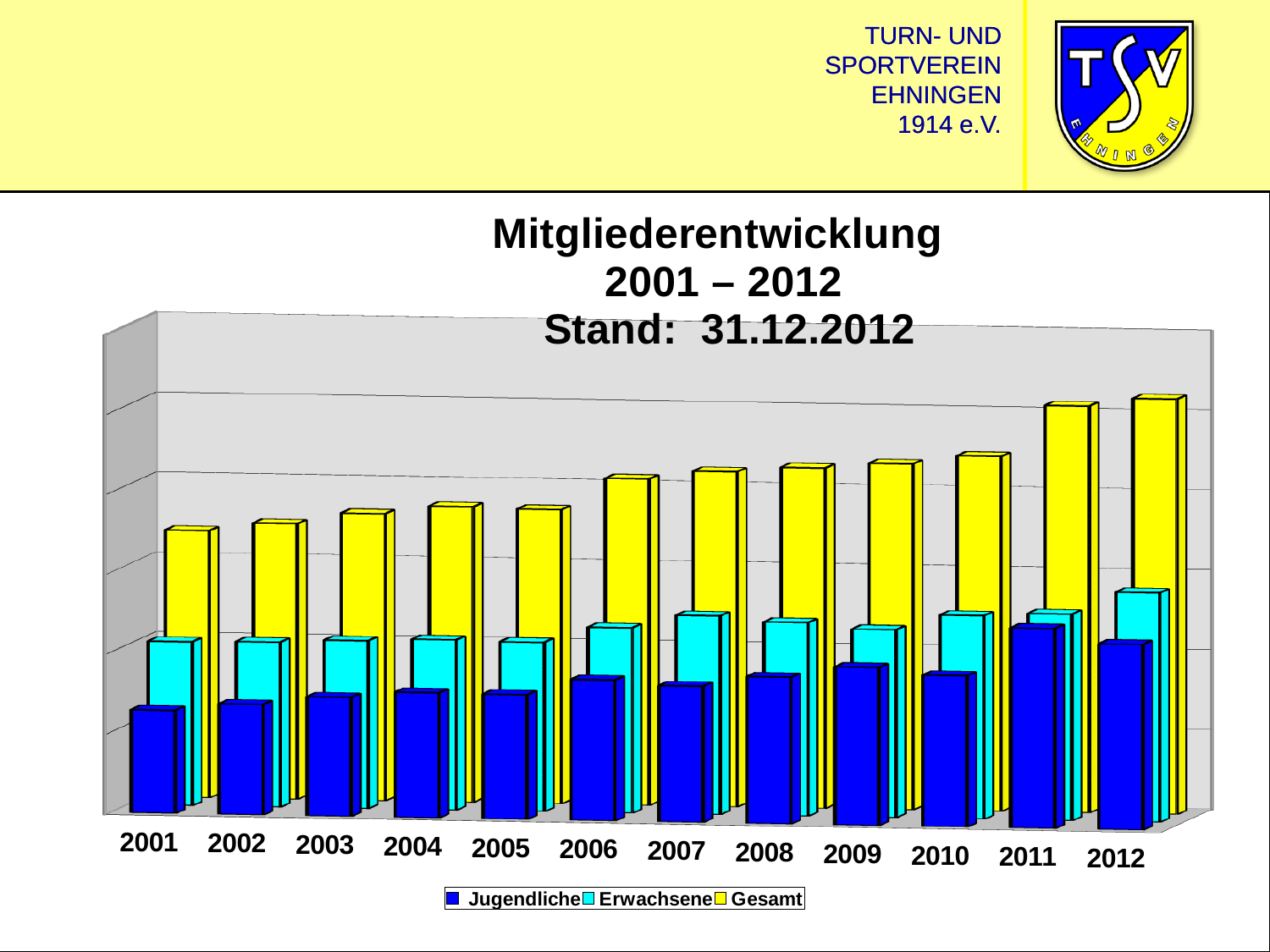
In which year is the Erwachsene value highest? 2012 Is the Gesamt value higher in 2006 or in 2005? 2006 Which series are listed in the legend of the chart? Jugendliche, Erwachsene, Gesamt Does the Gesamt value generally rise or fall from 2001 to 2012? rise What is the title of the chart? Mitgliederentwicklung 2001 – 2012 Stand: 31.12.2012 Is the Jugendliche value higher in 2011 or in 2001? 2011 In which year is the Gesamt value lowest? 2001 In which year is the Jugendliche value lowest? 2001 Is the Erwachsene value higher in 2012 or in 2009? 2012 How many years are shown on the x axis of the chart? 12 What kind of chart is shown on the slide? bar chart How many series does the legend of the chart list? 3